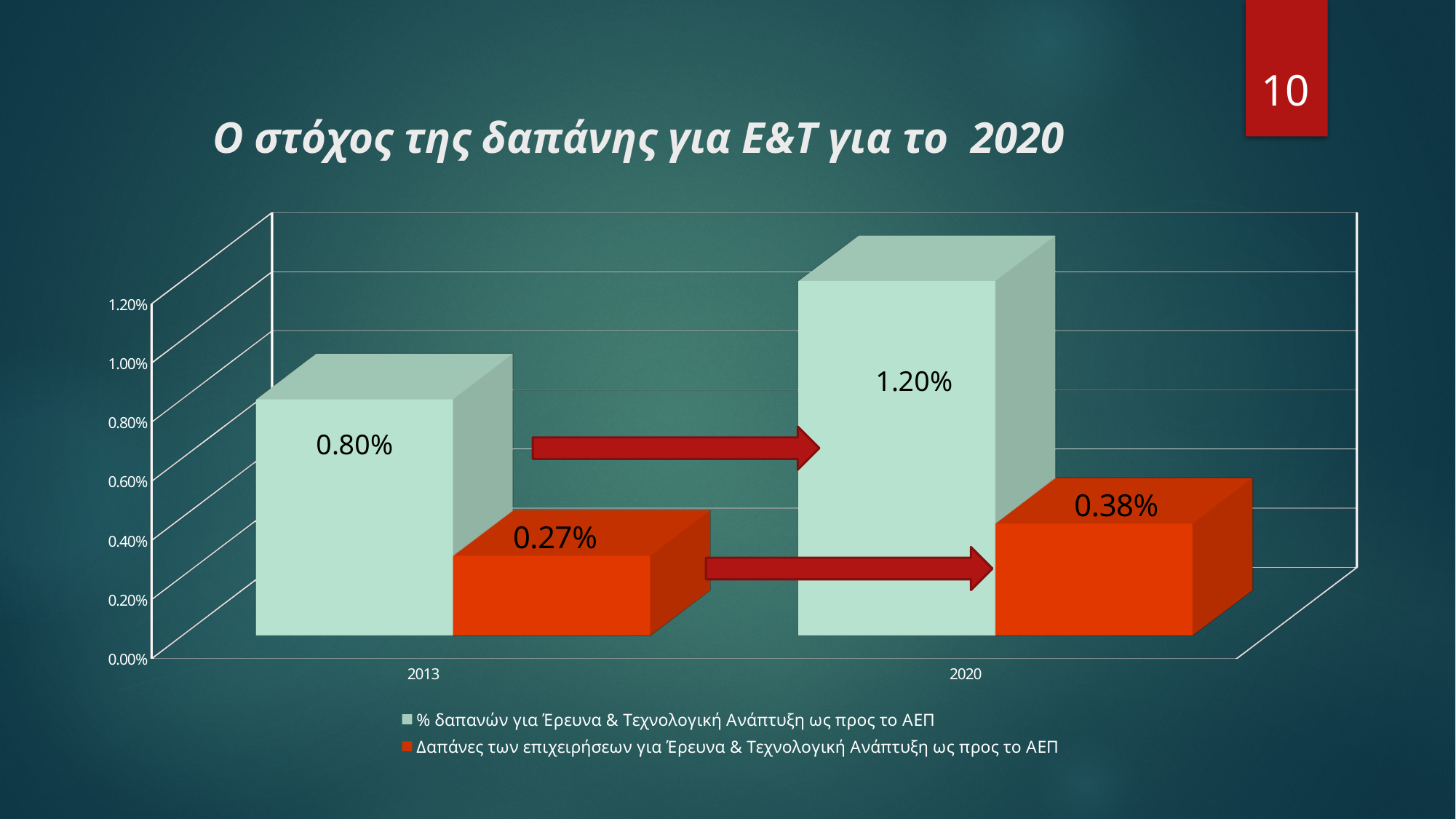
Which year has the higher value for '% δαπανών για Έρευνα & Τεχνολογική Ανάπτυξη ως προς το ΑΕΠ'? 2020 How many categories are shown on the x axis? 2 How many series does the legend list? 2 What is the value of 'Δαπάνες των επιχειρήσεων για Έρευνα & Τεχνολογική Ανάπτυξη ως προς το ΑΕΠ' for 2020? 0.38% What is the value of '% δαπανών για Έρευνα & Τεχνολογική Ανάπτυξη ως προς το ΑΕΠ' for 2013? 0.80% What is the value of 'Δαπάνες των επιχειρήσεων για Έρευνα & Τεχνολογική Ανάπτυξη ως προς το ΑΕΠ' for 2013? 0.27% Which series has the lower value in 2020? Δαπάνες των επιχειρήσεων για Έρευνα & Τεχνολογική Ανάπτυξη ως προς το ΑΕΠ Do the values of both series rise or fall from 2013 to 2020? Rise What is the value of '% δαπανών για Έρευνα & Τεχνολογική Ανάπτυξη ως προς το ΑΕΠ' for 2020? 1.20% By how much does '% δαπανών για Έρευνα & Τεχνολογική Ανάπτυξη ως προς το ΑΕΠ' increase from 2013 to 2020? 0.40% What kind of chart is shown on the slide? Bar chart By how much does 'Δαπάνες των επιχειρήσεων για Έρευνα & Τεχνολογική Ανάπτυξη ως προς το ΑΕΠ' increase from 2013 to 2020? 0.11%